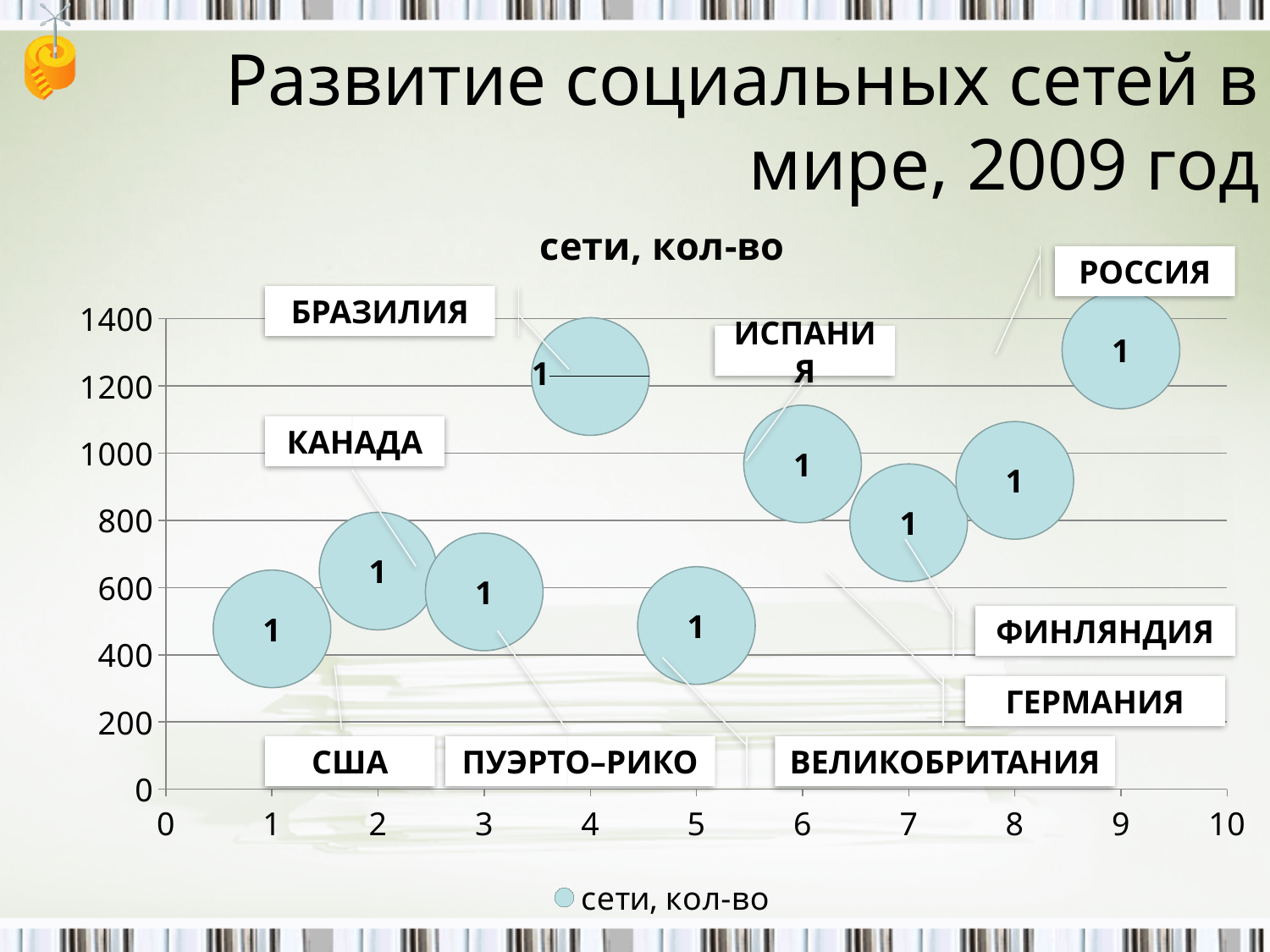
Is the value for РОССИЯ greater or less than 1200? greater How many series does the legend list? 1 Is the value for ВЕЛИКОБРИТАНИЯ greater or less than 600? less How many bubbles (countries) are plotted on the chart? 9 What kind of chart is shown on the slide? bubble chart Is the value for БРАЗИЛИЯ greater or less than 1000? greater What is the legend entry of the chart? сети, кол-во Which has the higher value, БРАЗИЛИЯ or США? БРАЗИЛИЯ What is the title of the chart? сети, кол-во Which has the higher value, ИСПАНИЯ or ВЕЛИКОБРИТАНИЯ? ИСПАНИЯ